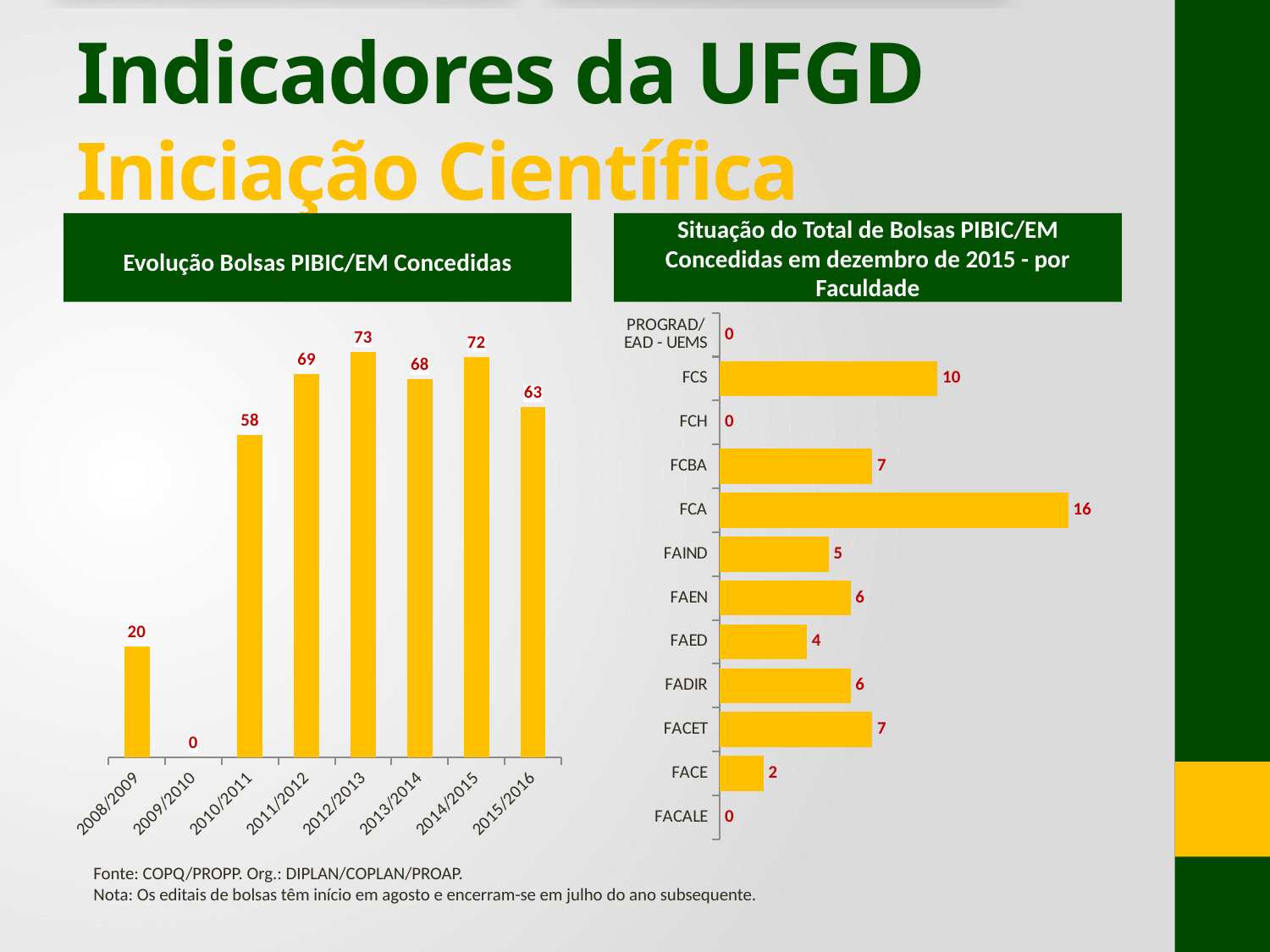
What kind of chart is the 'Situação do Total de Bolsas PIBIC/EM Concedidas em dezembro de 2015 - por Faculdade' chart? Bar chart In the 'Evolução Bolsas PIBIC/EM Concedidas' chart, which is larger, the value for 2011/2012 or the value for 2013/2014? 2011/2012 In the 'Evolução Bolsas PIBIC/EM Concedidas' chart, how many periods are shown on the x axis? 8 In the 'Situação do Total de Bolsas PIBIC/EM Concedidas em dezembro de 2015 - por Faculdade' chart, which faculty has the highest value? FCA In the 'Situação do Total de Bolsas PIBIC/EM Concedidas em dezembro de 2015 - por Faculdade' chart, what is the value for FCA? 16 In the 'Evolução Bolsas PIBIC/EM Concedidas' chart, which period has the highest value? 2012/2013 In the 'Situação do Total de Bolsas PIBIC/EM Concedidas em dezembro de 2015 - por Faculdade' chart, how many faculties are listed? 12 In the 'Evolução Bolsas PIBIC/EM Concedidas' chart, what is the difference between the values for 2014/2015 and 2015/2016? 9 In the 'Situação do Total de Bolsas PIBIC/EM Concedidas em dezembro de 2015 - por Faculdade' chart, what is the difference between the values for FCS and FCBA? 3 In the 'Situação do Total de Bolsas PIBIC/EM Concedidas em dezembro de 2015 - por Faculdade' chart, what is the value for FACE? 2 In the 'Evolução Bolsas PIBIC/EM Concedidas' chart, which period has the lowest value? 2009/2010 In the 'Evolução Bolsas PIBIC/EM Concedidas' chart, what is the value for 2012/2013? 73